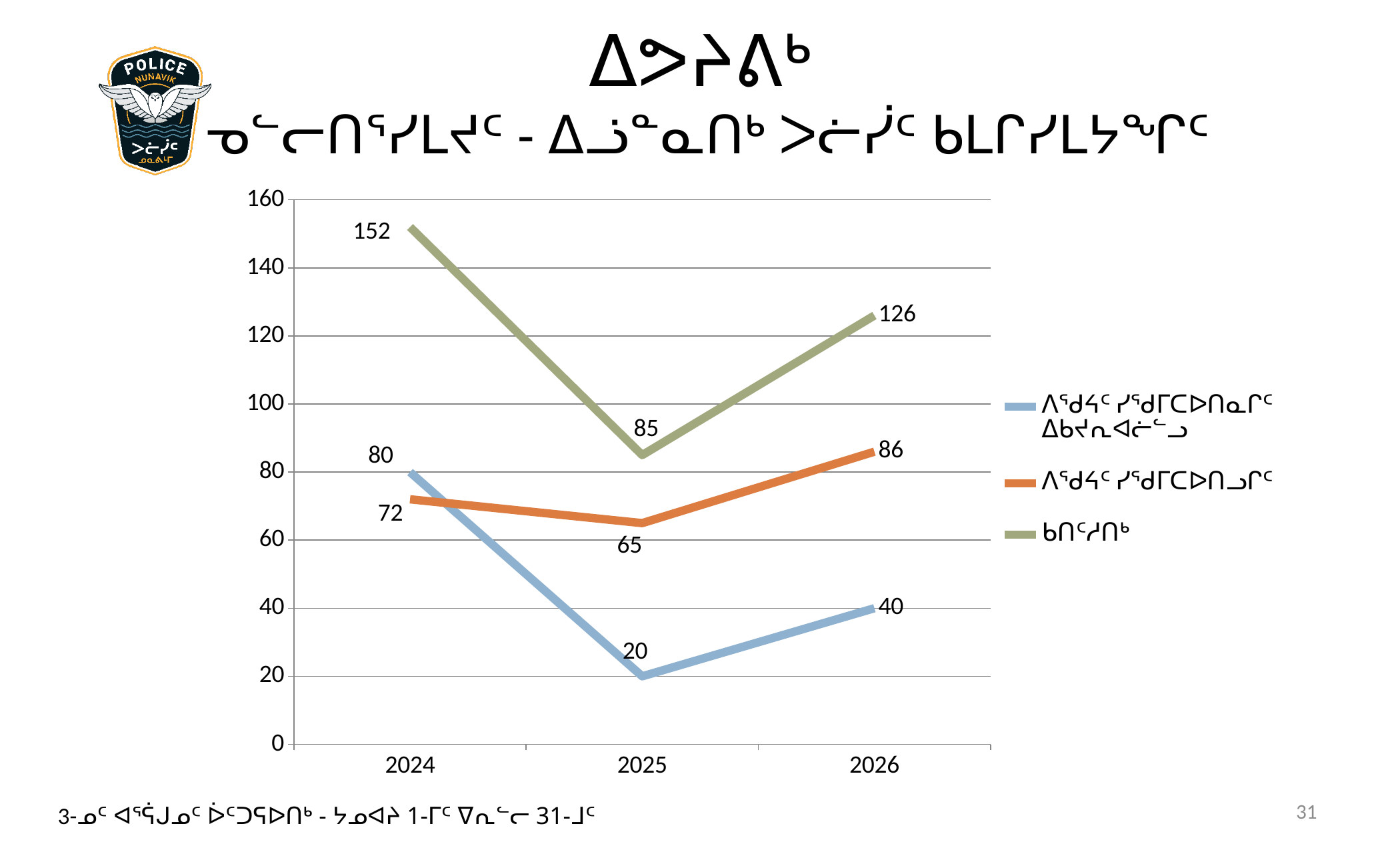
What is the value of the orange line in 2026? 86 By how much does the green line drop from 2024 to 2025? 67 Does the blue line rise or fall from 2024 to 2025? fall In 2024, which is larger: the blue line or the orange line? the blue line What is the difference between the blue line's values in 2026 and 2025? 20 In which year does the green line reach its highest value? 2024 What is the value of the blue line in 2025? 20 What kind of chart is shown on the slide? line chart In which year does the blue line reach its lowest value? 2025 How many years are shown on the x axis? 3 What is the value of the green line in 2024? 152 How many series does the legend list? 3